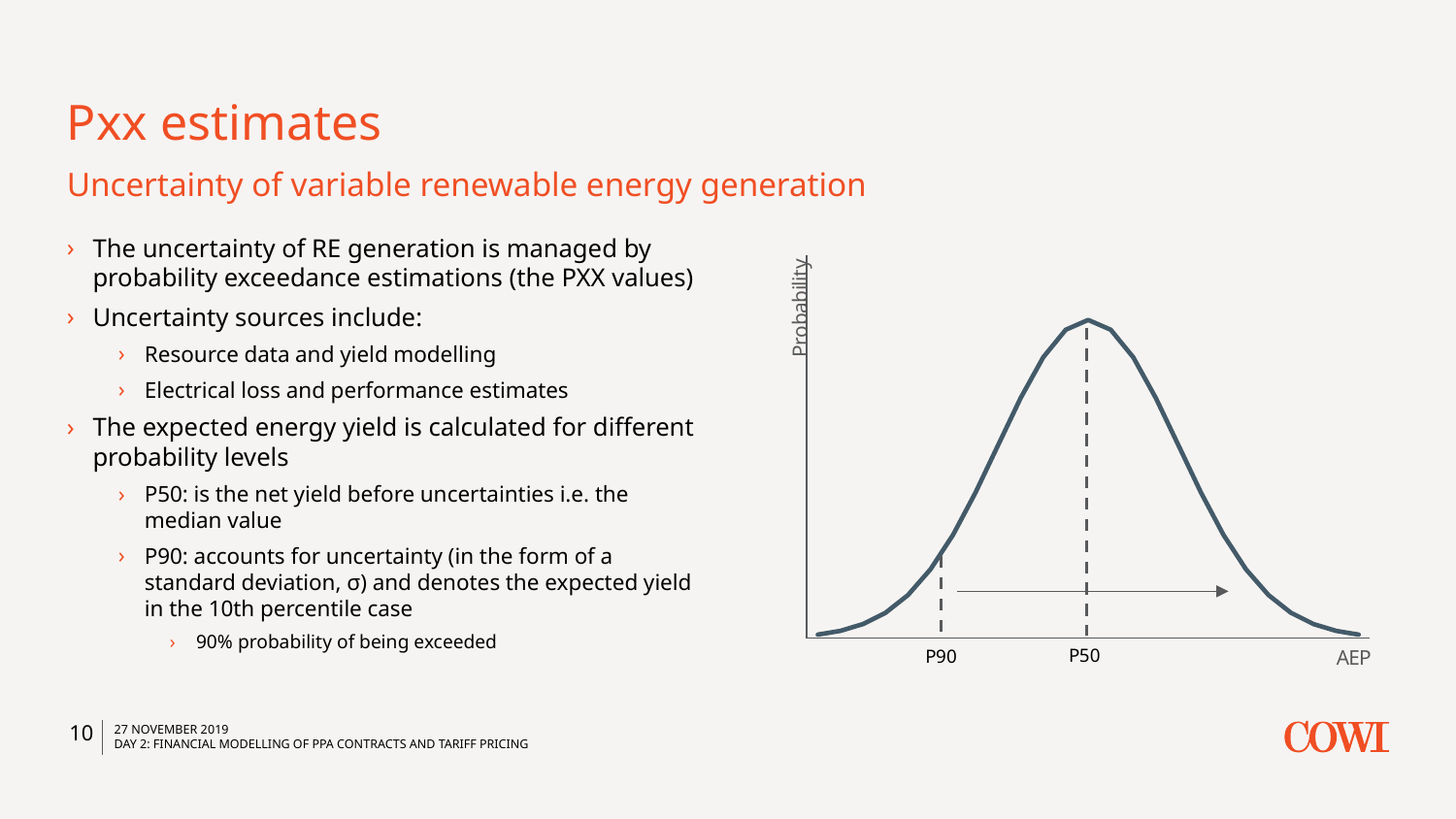
What is the label on the horizontal axis of the chart? AEP What is the label on the vertical axis of the chart? Probability Does the curve rise or fall to the right of P50 along the horizontal axis? Fall Is the probability value at P50 greater or less than the probability value at P90? greater How many labelled points are marked with dashed vertical lines on the chart? 2 Does the curve rise or fall as it moves from P90 to P50 along the horizontal axis? Rise Which labelled point on the horizontal axis lies at the peak of the curve? P50 What kind of chart is shown on the slide? Line chart In which direction does the horizontal arrow between P90 and P50 point? To the right Which of the two labelled points, P90 or P50, is further to the left on the horizontal axis? P90